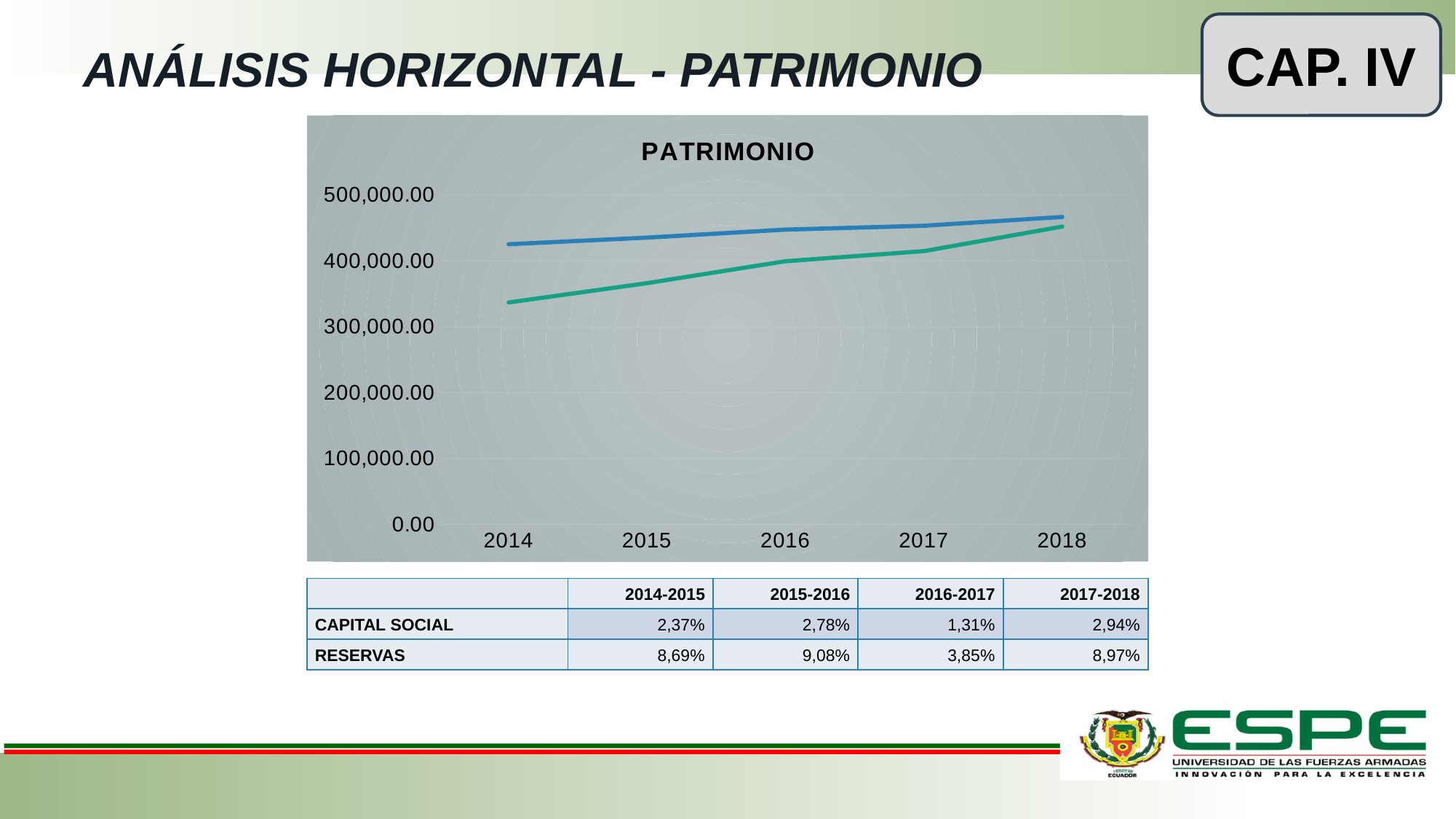
What is the title of the chart? PATRIMONIO How many lines are plotted in the chart? 2 In 2014, which line has the higher value, the blue line or the green line? the blue line Do the values of the blue line rise or fall from 2014 to 2018? rise Is the value of the blue line in 2018 greater or less than 500,000.00? less In which year does the green line reach its lowest value? 2014 Is the value of the green line in 2018 greater or less than 400,000.00? greater Do the values of the green line rise or fall from 2014 to 2018? rise Is the value of the green line in 2014 greater or less than 400,000.00? less How many years are shown on the x axis of the chart? 5 What kind of chart is shown on the slide? line chart